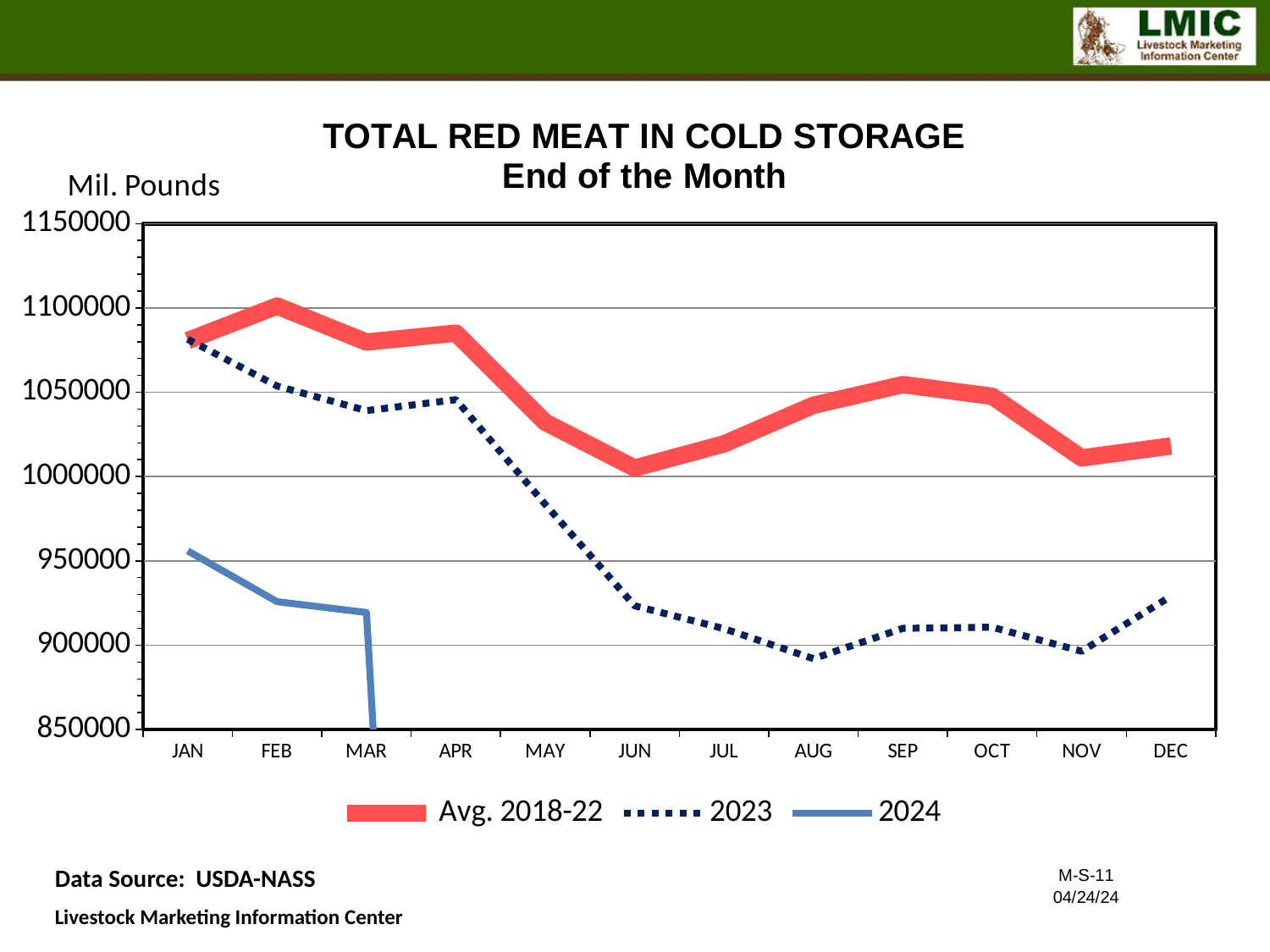
How many months are shown along the x axis? 12 In JAN, which series is higher, Avg. 2018-22 or 2024? Avg. 2018-22 In which month is the 2023 series at its highest? JAN Is the 2024 value for FEB greater or less than 950000? less What kind of chart is shown on the slide? line chart Is the 2023 value for JUN greater or less than 950000? less Is the Avg. 2018-22 value for JAN greater or less than 1050000? greater What unit label is shown above the y axis? Mil. Pounds How many series does the legend list? 3 Does the 2023 series rise or fall from APR to JUN? fall In which month is the Avg. 2018-22 series at its highest? FEB In which month is the Avg. 2018-22 series at its lowest? JUN